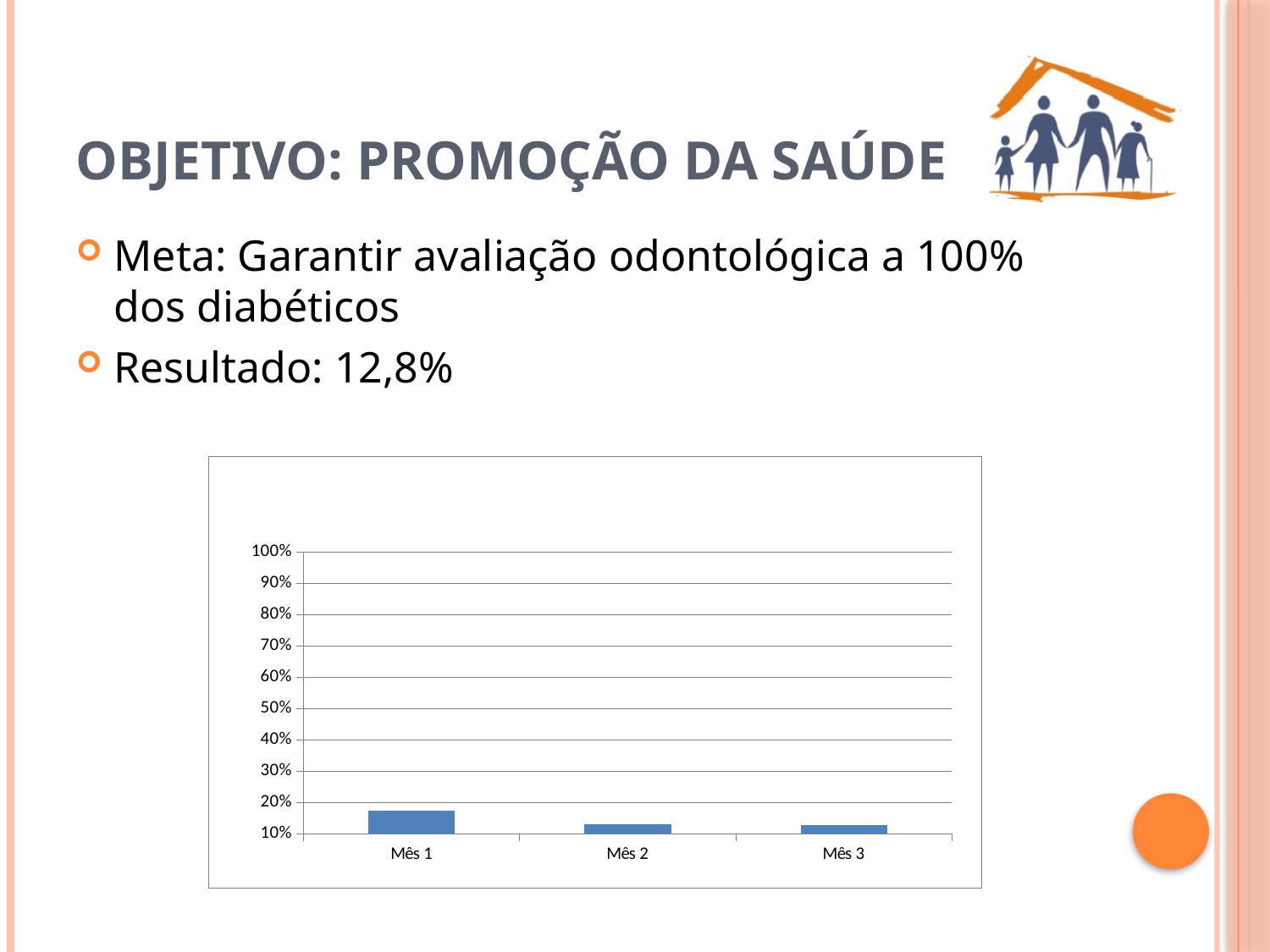
Which category has the highest bar in the chart? Mês 1 Is the value for Mês 1 greater or less than 10%? greater Which is larger, the value for Mês 1 or the value for Mês 2? Mês 1 Which is larger, the value for Mês 1 or the value for Mês 3? Mês 1 Is the value for Mês 2 greater or less than 20%? less What is the highest value shown on the chart's y axis? 100% Is the value for Mês 1 greater or less than 20%? less Do the values rise or fall from Mês 1 to Mês 3? fall What is the label of the first category on the x axis? Mês 1 What kind of chart is shown on the slide? bar chart How many categories are plotted on the x axis of the chart? 3